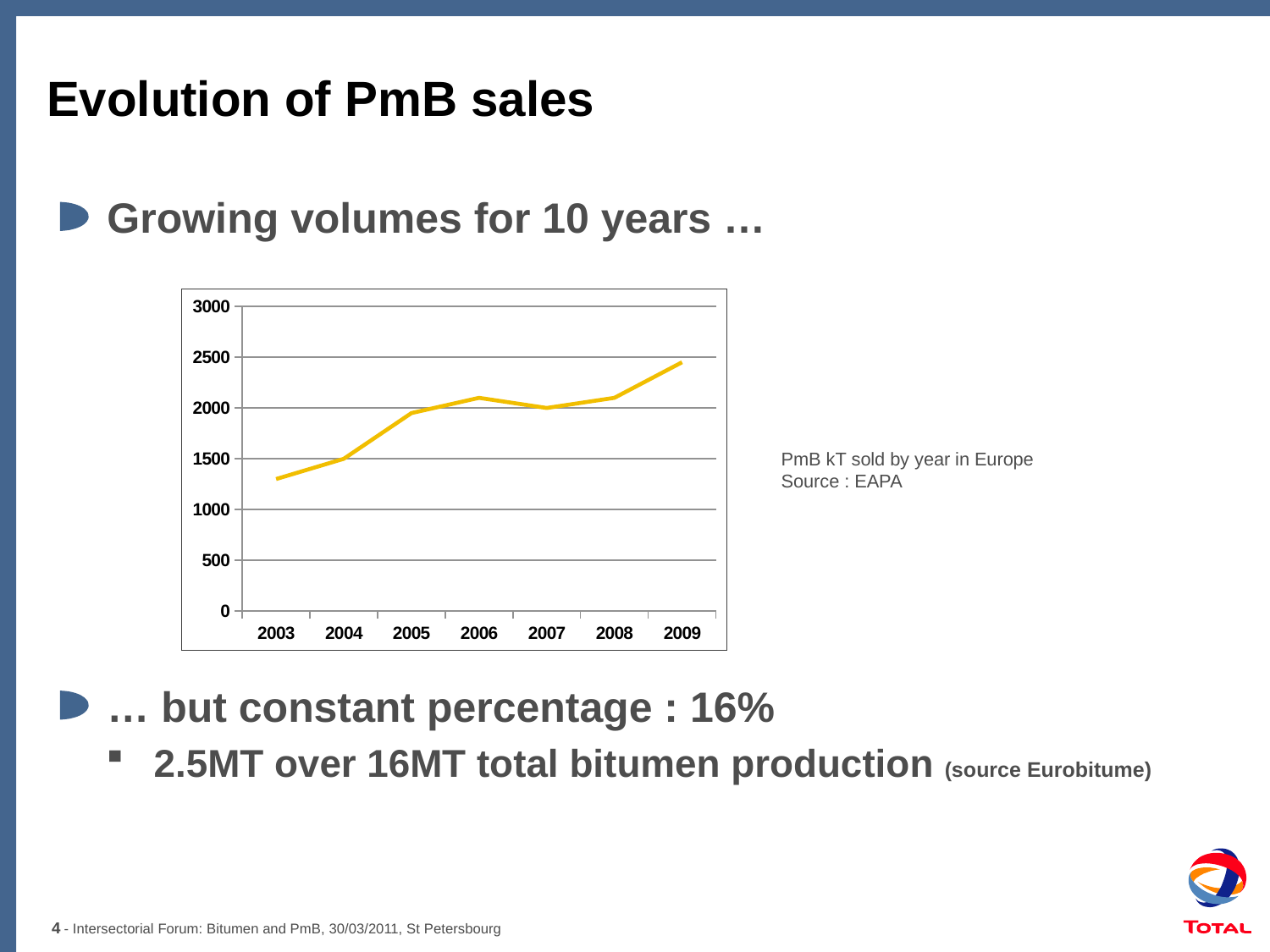
Is the value for 2003 greater or less than 1500? less Which year has the lowest value in the chart? 2003 What kind of chart is shown on the slide? line chart Which year has the highest value in the chart? 2009 What is the highest value shown on the chart's y axis? 3000 Do the values generally rise or fall from 2003 to 2009? rise Is the value for 2006 greater or less than 2000? greater According to the caption next to the chart, what is the source of the data? EAPA Which year has the larger value, 2004 or 2006? 2006 How many years are plotted on the x axis of the chart? 7 Is the value for 2009 greater or less than 2000? greater